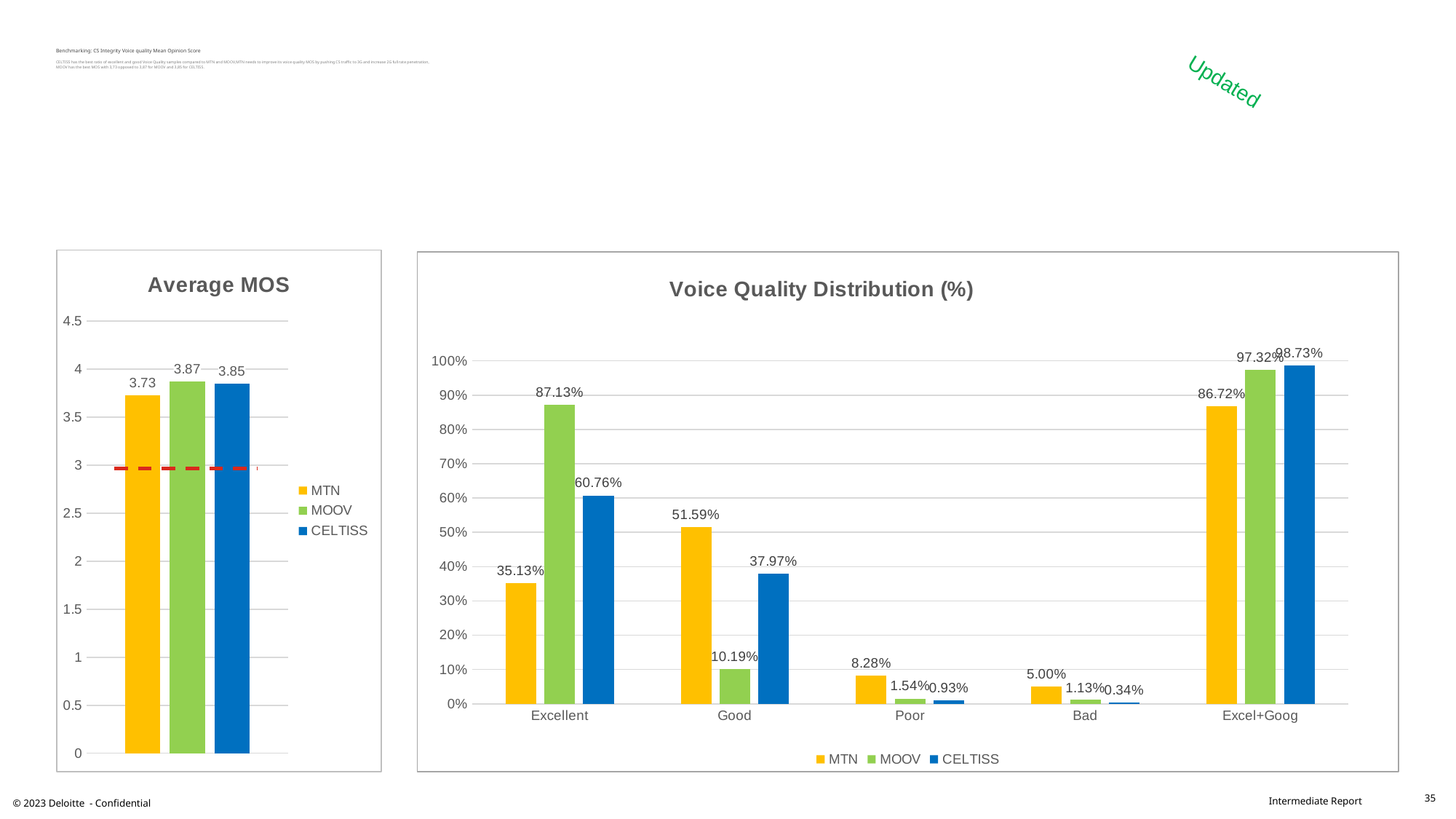
In the Average MOS chart, what is the difference between the MOOV and MTN values? 0.14 In the Average MOS chart, which operator has the lowest average MOS? MTN In the Voice Quality Distribution (%) chart, which operator has the highest value in the Poor category? MTN In the Voice Quality Distribution (%) chart, what is the value for MOOV in the Excellent category? 87.13% In the Voice Quality Distribution (%) chart, what is the difference between the MOOV and MTN values in the Excellent category? 52.00% What kind of chart is the Voice Quality Distribution (%) chart? Bar chart In the Voice Quality Distribution (%) chart, is the value for MTN in the Excel+Goog category greater or less than 80%? greater In the Voice Quality Distribution (%) chart, what is the value for CELTISS in the Good category? 37.97% How many series does the legend of the Average MOS chart list? 3 How many categories are shown on the x axis of the Voice Quality Distribution (%) chart? 5 In the Voice Quality Distribution (%) chart, which is larger in the Good category: MTN or CELTISS? MTN In the Average MOS chart, what is the value for MOOV? 3.87